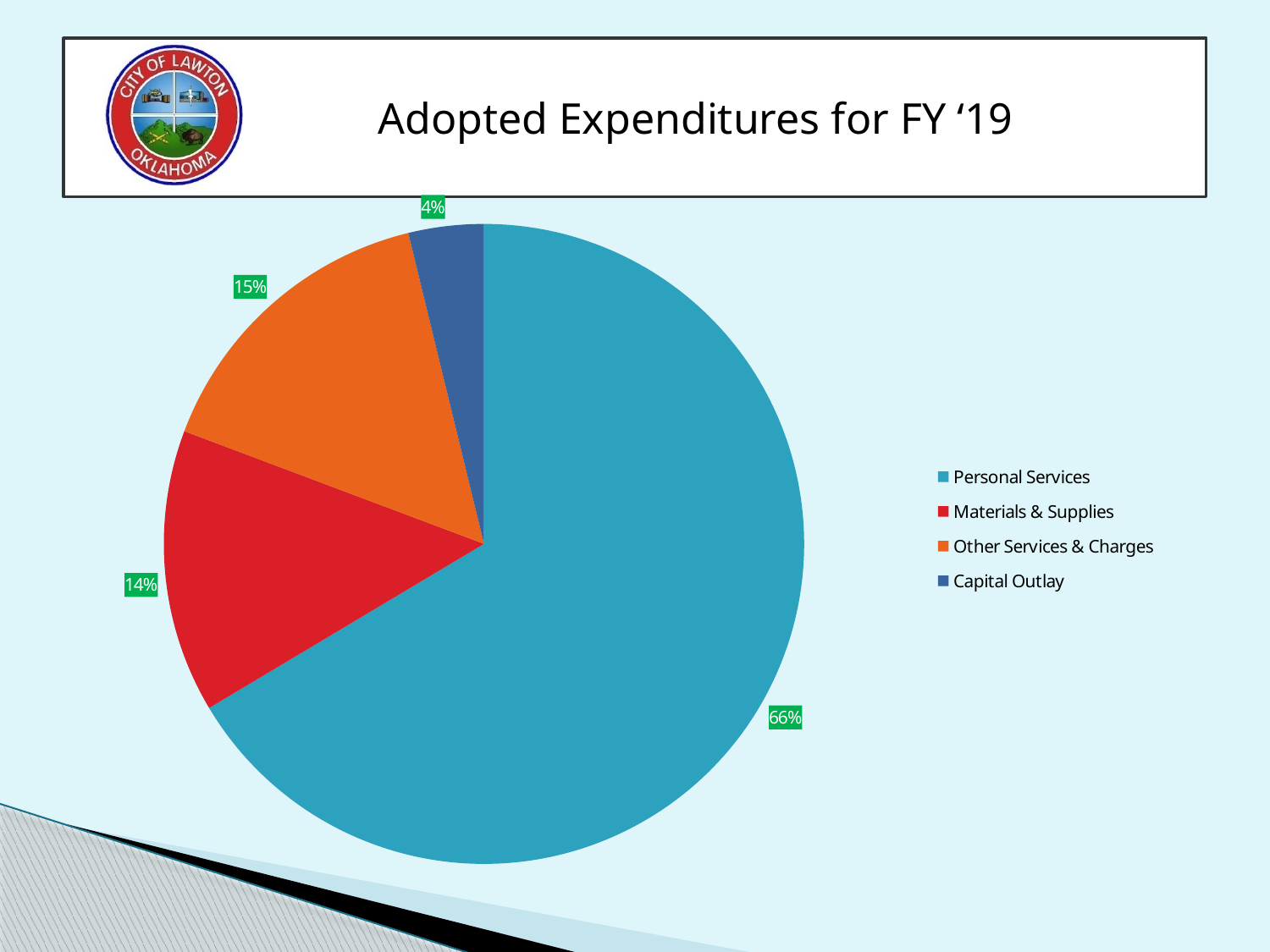
What is the title of the chart? Adopted Expenditures for FY '19 What share of adopted expenditures for FY '19 is Capital Outlay? 4% Which colour represents Capital Outlay in the pie chart? dark blue What share of adopted expenditures for FY '19 is Other Services & Charges? 15% What share of adopted expenditures for FY '19 is Materials & Supplies? 14% Which category has the largest share of adopted expenditures for FY '19? Personal Services What is the difference in percentage points between Personal Services and Other Services & Charges? 51 Which category has the smallest share of adopted expenditures for FY '19? Capital Outlay How many categories are shown in the pie chart? 4 What kind of chart is shown on the slide? pie chart Which is larger, the share for Personal Services or the share for Other Services & Charges? Personal Services